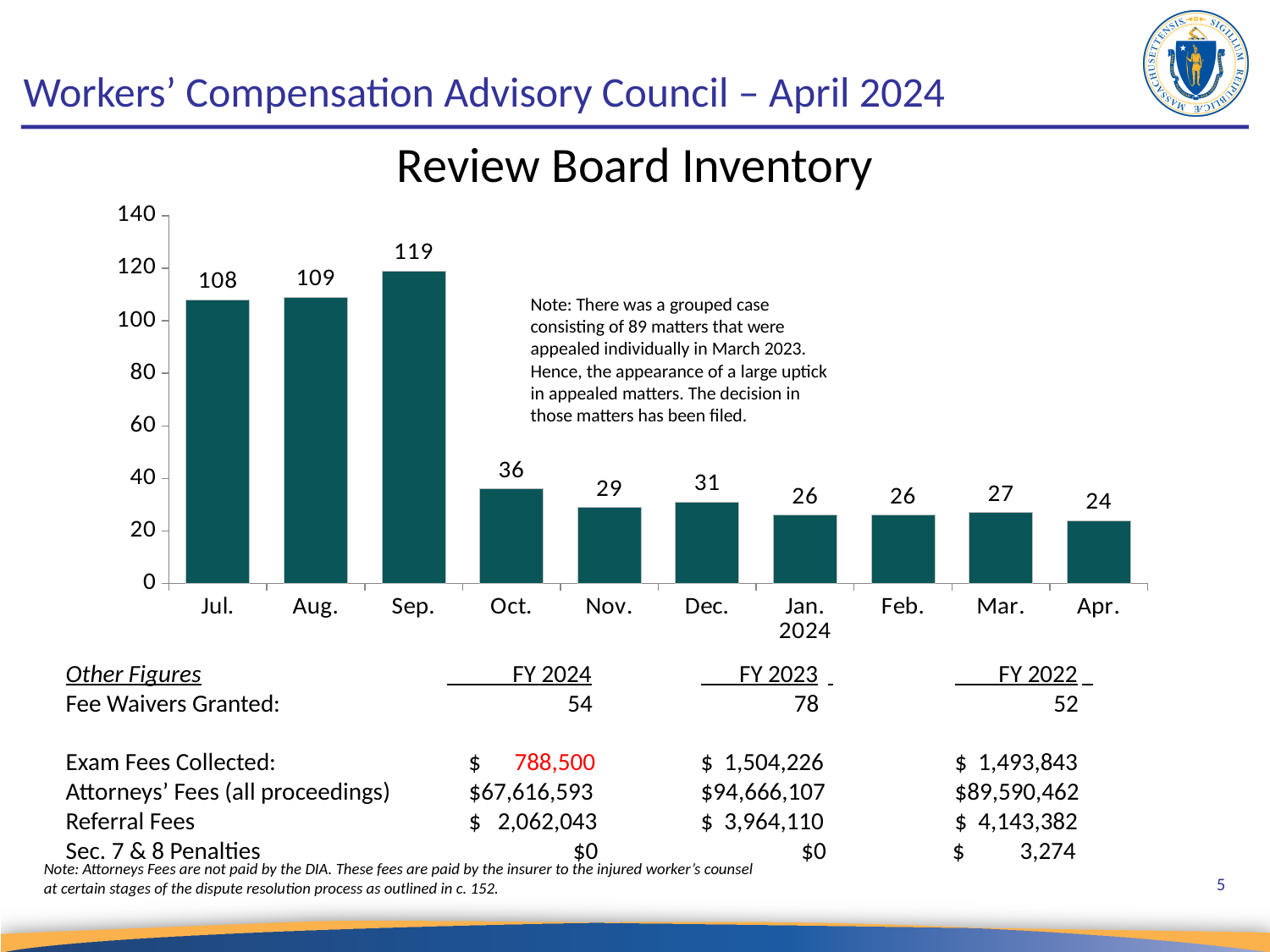
What is the difference between the Review Board Inventory values for Sep. and Oct.? 83 What is the title of the chart on the slide? Review Board Inventory What is the Review Board Inventory value for Apr.? 24 How many months are shown on the Review Board Inventory chart? 10 Which month has the highest Review Board Inventory value? Sep. What kind of chart is the Review Board Inventory chart? bar chart Is the value for Aug. greater or less than 100? greater Do the Review Board Inventory values rise or fall from Sep. to Oct.? fall Which is larger, the Review Board Inventory value for Nov. or for Dec.? Dec. Which month has the lowest Review Board Inventory value? Apr. What is the Review Board Inventory value for Sep.? 119 What is the Review Board Inventory value for Oct.? 36